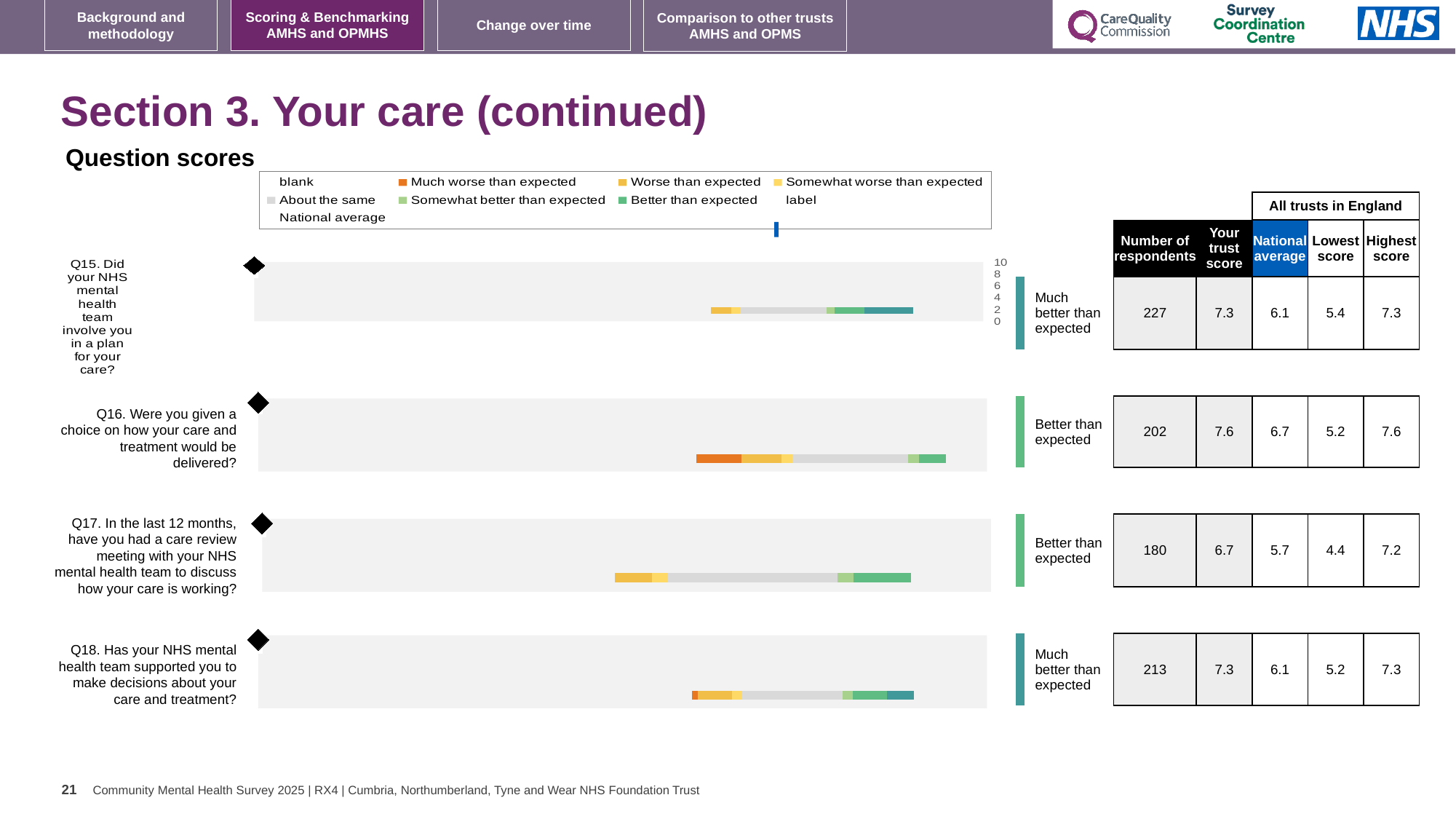
What kind of chart is used to show the question scores for Q15 to Q18? Bar chart Which has the higher trust score, Q16 or Q17? Q16 What is the number of respondents for Q15? 227 How many legend entries contain the word 'expected'? 5 What is the lowest score across all trusts in England for Q18? 5.2 What is the national average for Q17? 5.7 How many questions (Q15 to Q18) have a bar plotted on the slide? 4 What rating label is shown next to the bar for Q16? Better than expected By how much does the trust score for Q17 exceed the national average for Q17? 1.0 What is the 'Your trust score' value for Q16? 7.6 Which question has the lowest 'Lowest score' value? Q17 Which question has the highest number of respondents? Q15